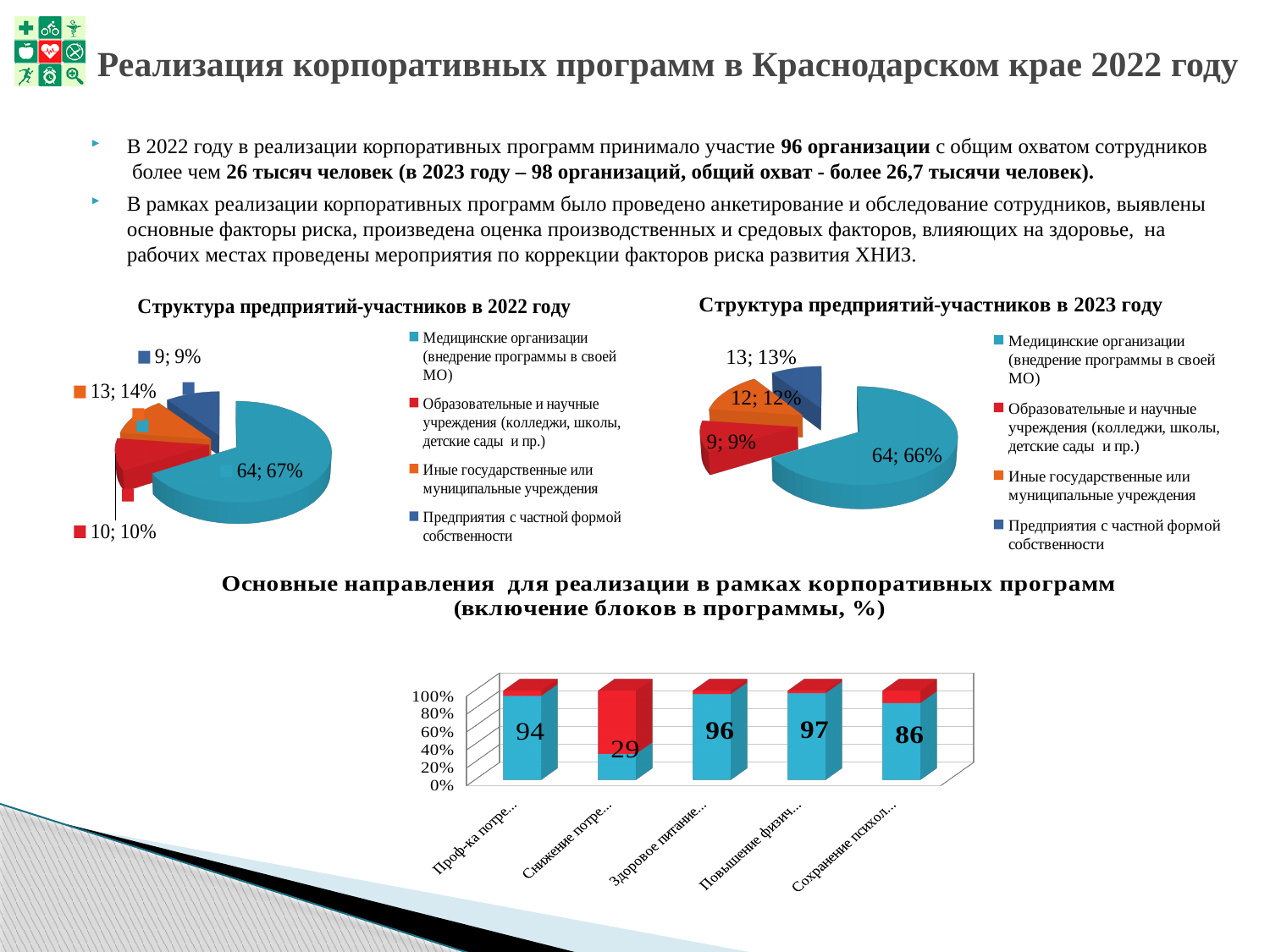
In the bar chart at the bottom of the slide, what is the value labelled on the second bar (Снижение потре...)? 29 In the pie chart 'Структура предприятий-участников в 2022 году', what is the value shown for Медицинские организации? 64; 67% In the pie chart 'Структура предприятий-участников в 2023 году', what is the value shown for Предприятия с частной формой собственности? 13; 13% In the bar chart at the bottom of the slide, which bar has the highest labelled value? Повышение физич... (97) In the bar chart at the bottom of the slide, how many bars are plotted? 5 In the pie chart 'Структура предприятий-участников в 2022 году', what is the difference in count between Иные государственные или муниципальные учреждения and Образовательные и научные учреждения? 3 In the pie chart 'Структура предприятий-участников в 2023 году', which category has the largest share? Медицинские организации How many categories does the legend of the pie chart 'Структура предприятий-участников в 2022 году' list? 4 What kind of chart is the chart titled 'Основные направления для реализации в рамках корпоративных программ'? Bar chart In the pie chart 'Структура предприятий-участников в 2022 году', which category has the smallest share? Предприятия с частной формой собственности In the pie chart 'Структура предприятий-участников в 2023 году', what percentage share do Образовательные и научные учреждения have? 9% In the pie chart 'Структура предприятий-участников в 2023 году', which is larger: Иные государственные или муниципальные учреждения or Образовательные и научные учреждения? Иные государственные или муниципальные учреждения